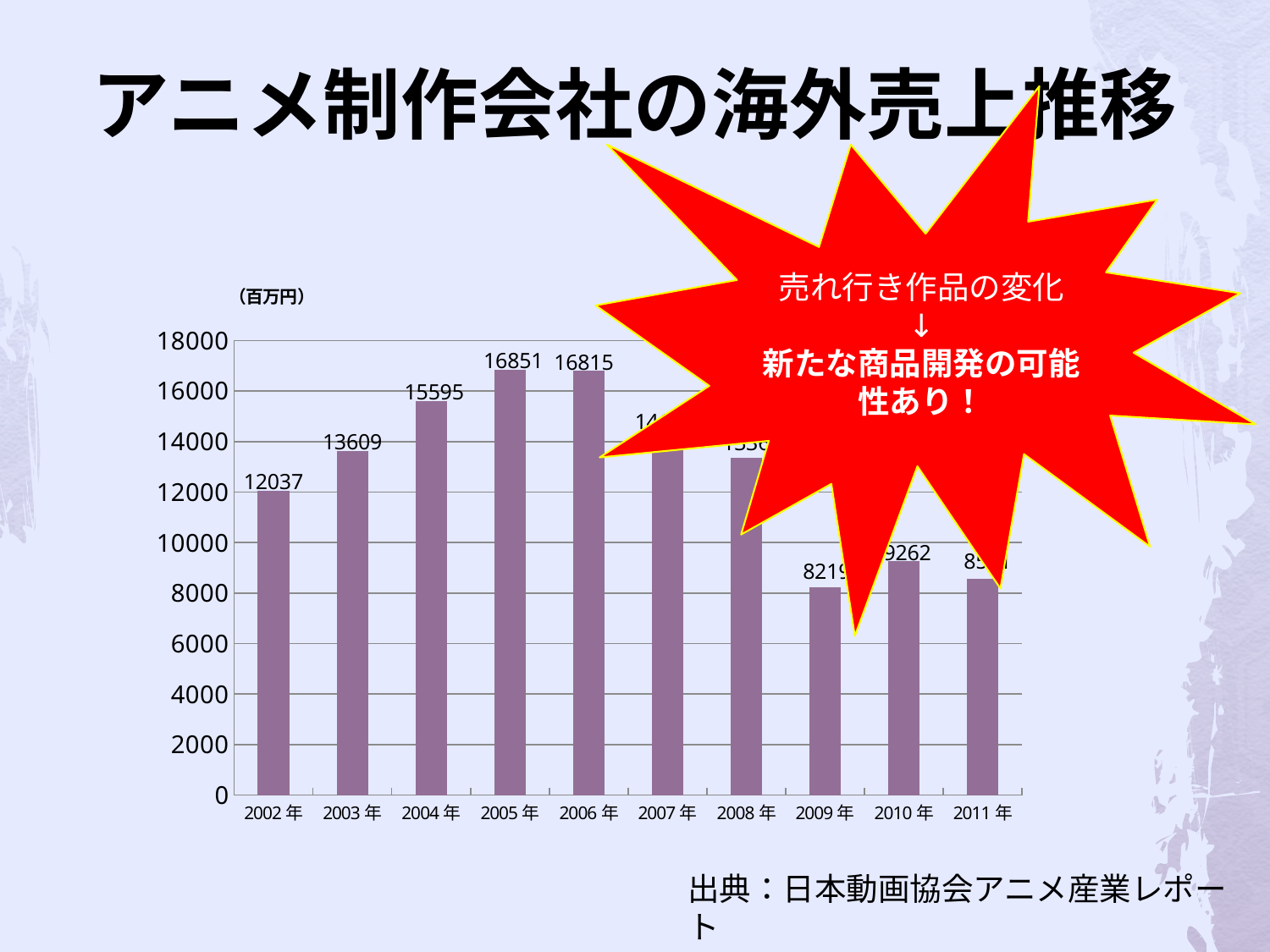
What is the value for 2002年? 12037 What is the difference between the values for 2005年 and 2004年? 1256 Is the value for 2009年 greater or less than 10000? less What kind of chart is shown? bar chart Is the value for 2011年 greater or less than 10000? less Which year has the highest value? 2005年 What is the value for 2004年? 15595 What is the difference between the values for 2003年 and 2002年? 1572 Do the values rise or fall from 2002年 to 2005年? rise What is the value for 2006年? 16815 How many years are shown on the x axis? 10 Which is larger, the value for 2004年 or 2003年? 2004年